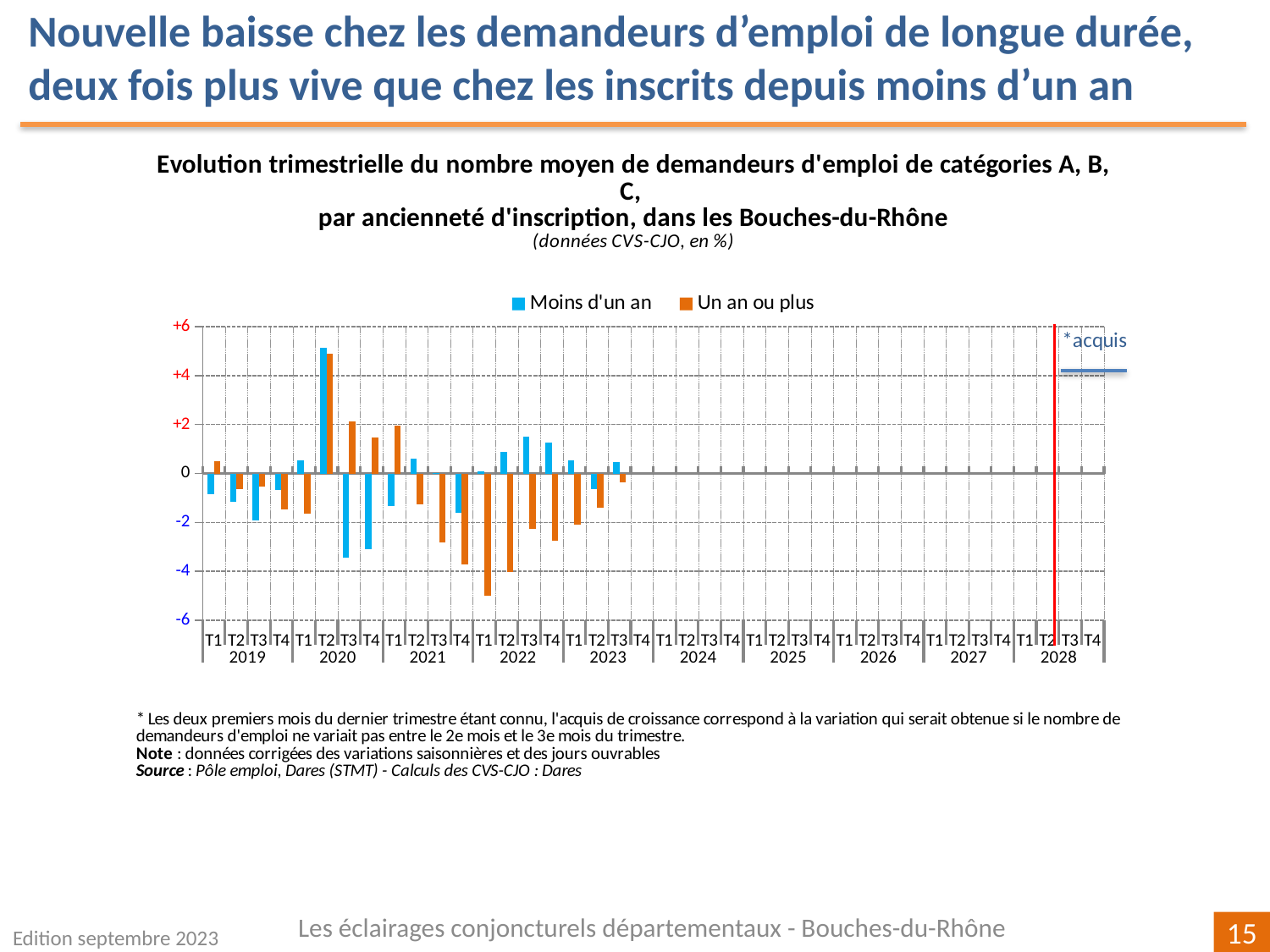
In which quarter does the 'Un an ou plus' series reach its highest value? T2 2020 Is the value for 'Un an ou plus' in T1 2022 greater or less than -4? less In which quarter does the 'Moins d'un an' series reach its highest value? T2 2020 In T3 2021, which series has the larger value, 'Moins d'un an' or 'Un an ou plus'? Moins d'un an Which colour represents the series 'Un an ou plus'? Orange In which quarter does the 'Un an ou plus' series reach its lowest value? T1 2022 How many years are labelled along the x axis? 10 What kind of chart is shown on the slide? Bar chart Is the value for 'Moins d'un an' in T3 2020 greater or less than -2? less What are the two series named in the legend? Moins d'un an; Un an ou plus Is the value for 'Moins d'un an' in T2 2020 greater or less than +4? greater How many series does the legend list? 2